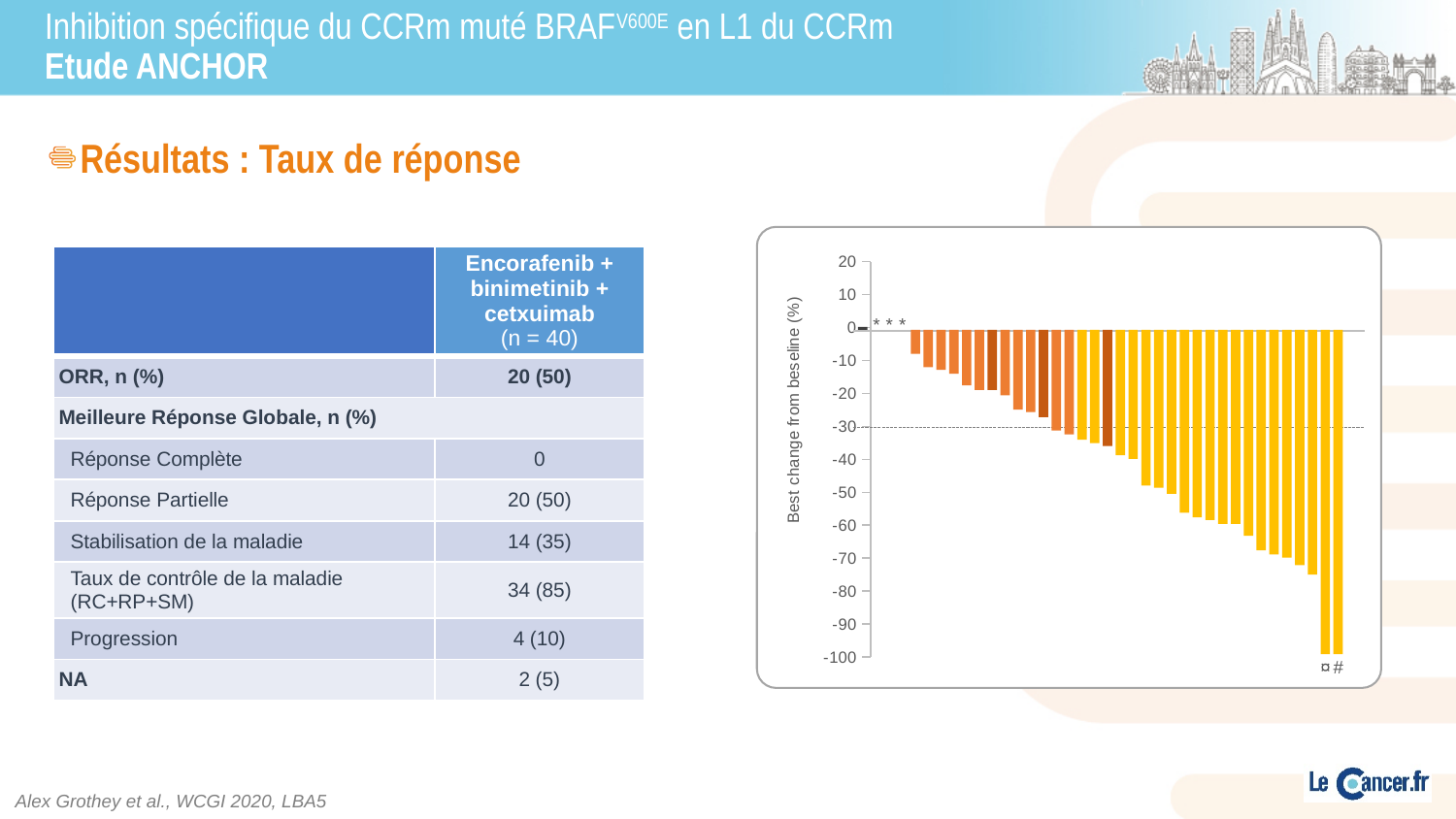
What kind of chart is shown on the right of the slide? bar chart At what value is the dashed horizontal reference line drawn on the chart? -30 What is the label of the vertical axis of the chart? Best change from baseline (%) Do the bar values rise or fall from left to right along the x axis of the chart? fall Is the value of the leftmost bar in the chart greater or less than -20? greater Is the value of the rightmost bar in the chart greater or less than -90? less What is the lowest value shown on the vertical axis of the chart? -100 Which bar has the lowest value in the chart, the leftmost or the rightmost? rightmost What is the highest value shown on the vertical axis of the chart? 20